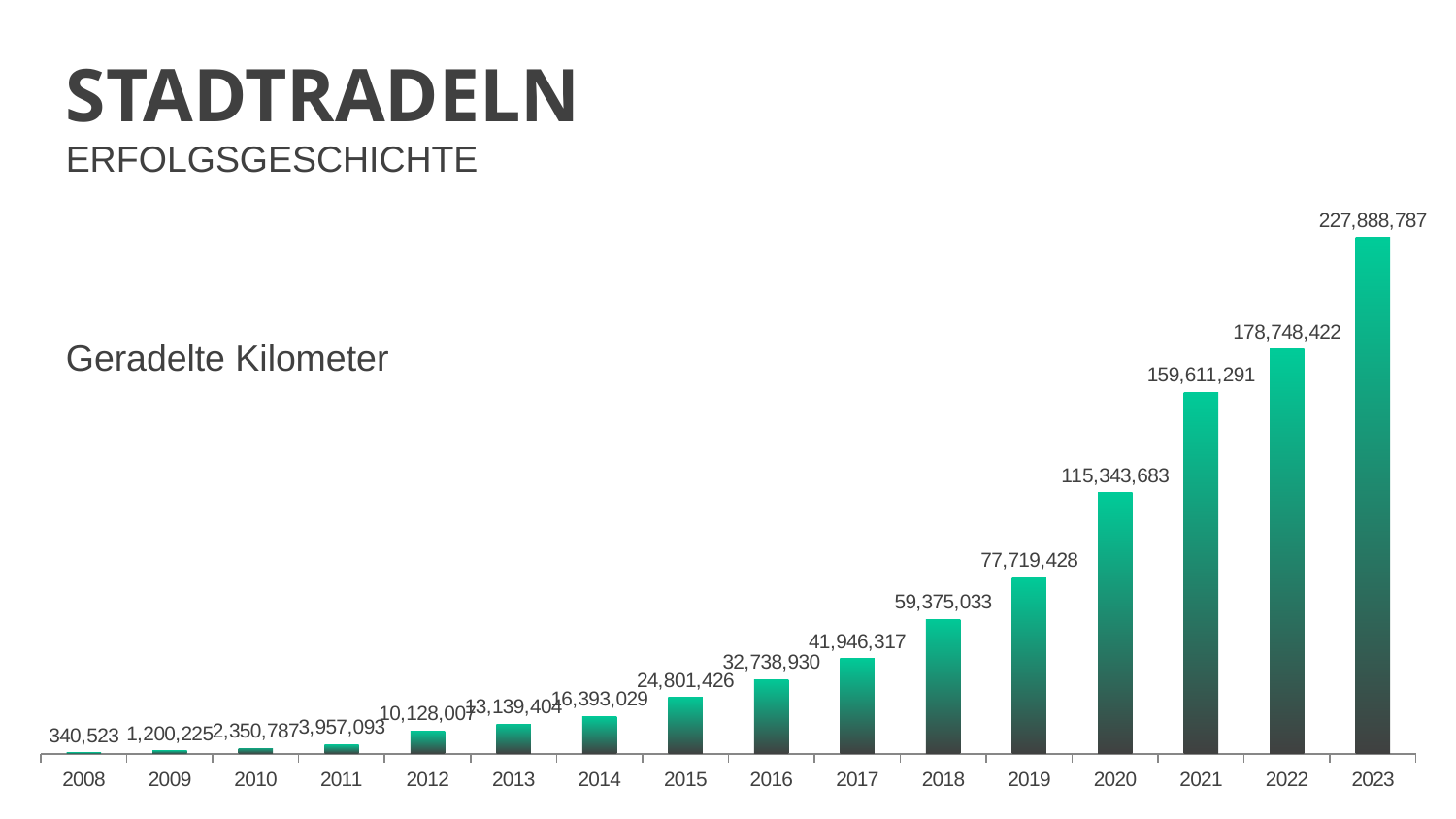
What kind of chart is shown on the slide? Bar chart Do the values rise or fall from 2008 to 2023? Rise How many years are shown on the x axis? 16 What value is shown for 2017? 41,946,317 Which year has the highest value? 2023 What value is shown for 2020? 115,343,683 What is the difference between the values for 2023 and 2022? 49,140,365 What is the difference between the values for 2021 and 2020? 44,267,608 What value is shown for 2008? 340,523 What value is shown for 2023? 227,888,787 Which year has the lowest value? 2008 Which is larger, the value for 2018 or the value for 2019? 2019